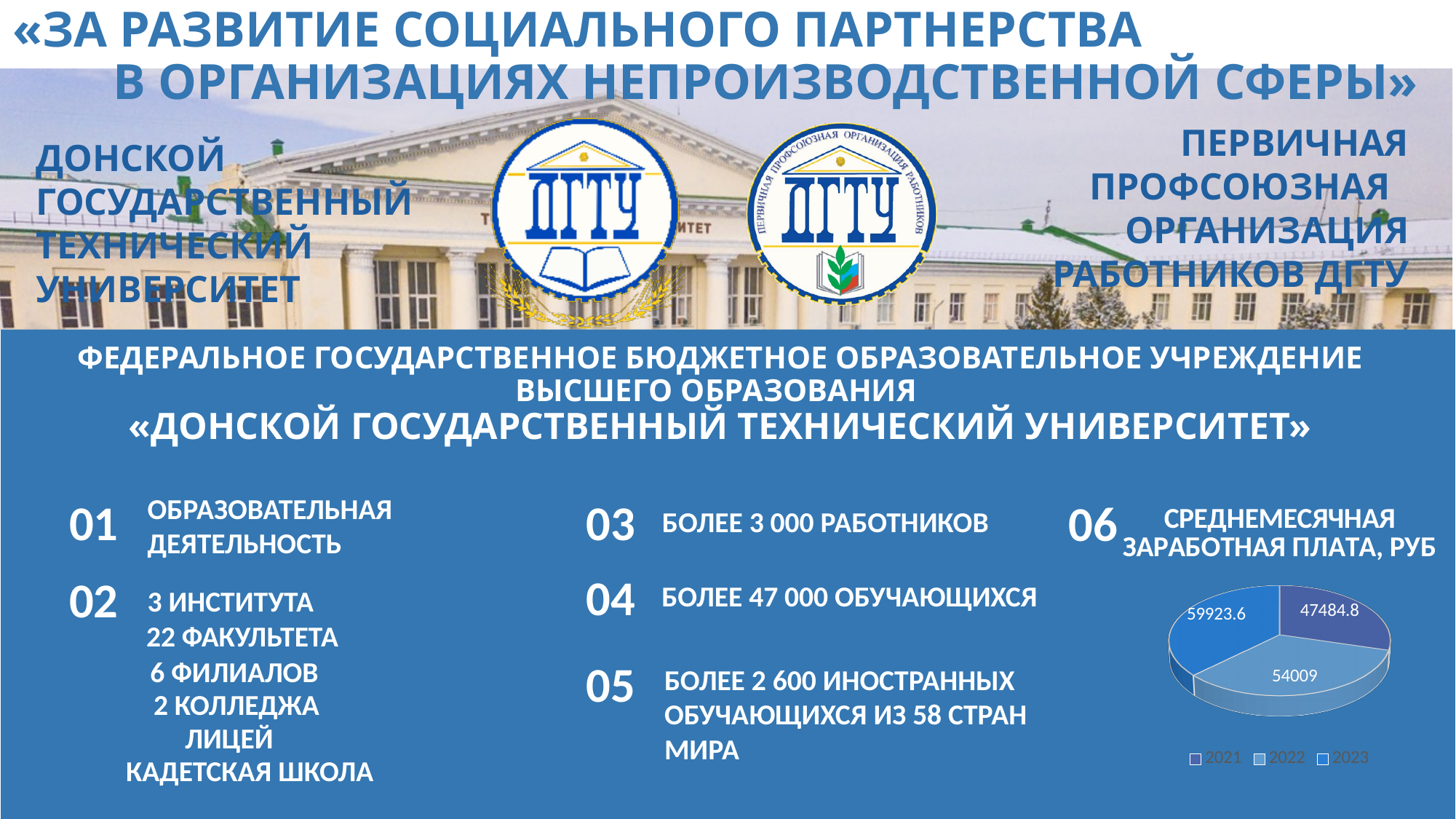
Which year has the largest value in the pie chart? 2023 What is the value for 2022 in the pie chart? 54009 What is the difference between the values for 2022 and 2021 in the pie chart? 6524.2 What is the difference between the values for 2023 and 2021 in the pie chart? 12438.8 What is the value for 2023 in the pie chart? 59923.6 What does the heading above the pie chart say the chart shows? СРЕДНЕМЕСЯЧНАЯ ЗАРАБОТНАЯ ПЛАТА, РУБ Which is larger in the pie chart, the value for 2022 or the value for 2023? 2023 How many entries does the legend of the pie chart list? 3 What is the value for 2021 in the pie chart? 47484.8 What type of chart is shown on the slide? pie chart Which year has the smallest value in the pie chart? 2021 How many slices does the pie chart have? 3